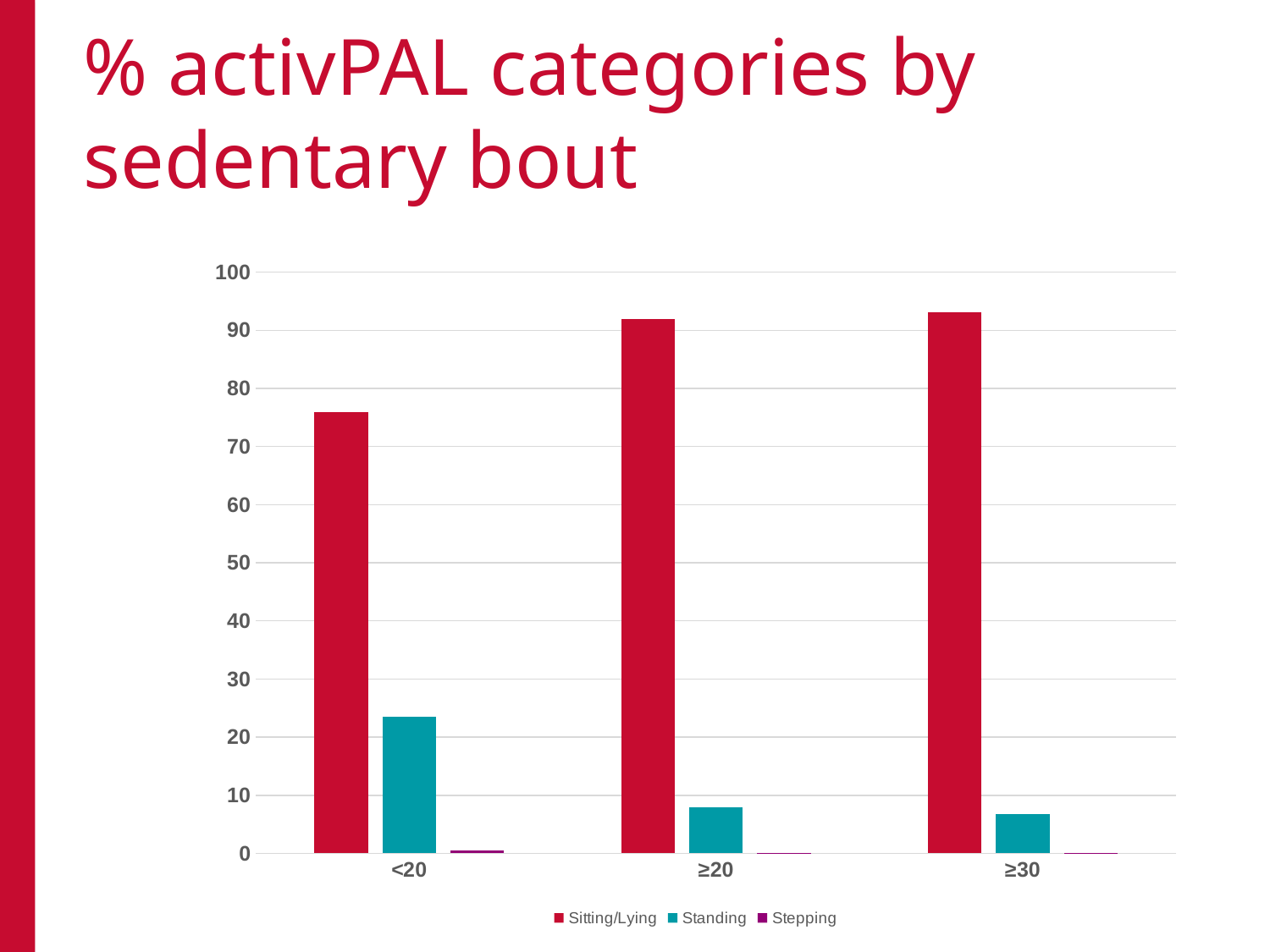
Which sedentary bout category has the lowest Sitting/Lying value? <20 What kind of chart is shown on the slide? bar chart Which sedentary bout category has the highest Standing value? <20 Which is larger for the ≥20 category, Sitting/Lying or Standing? Sitting/Lying Is the Standing value for the ≥30 category greater or less than 10? less Is the Sitting/Lying value for the ≥20 category greater or less than 90? greater Is the Standing value for the <20 category greater or less than 20? greater Which series are listed in the legend? Sitting/Lying, Standing, Stepping How many series does the legend list? 3 How many sedentary bout categories are shown on the x axis? 3 What is the title of the slide containing the chart? % activPAL categories by sedentary bout